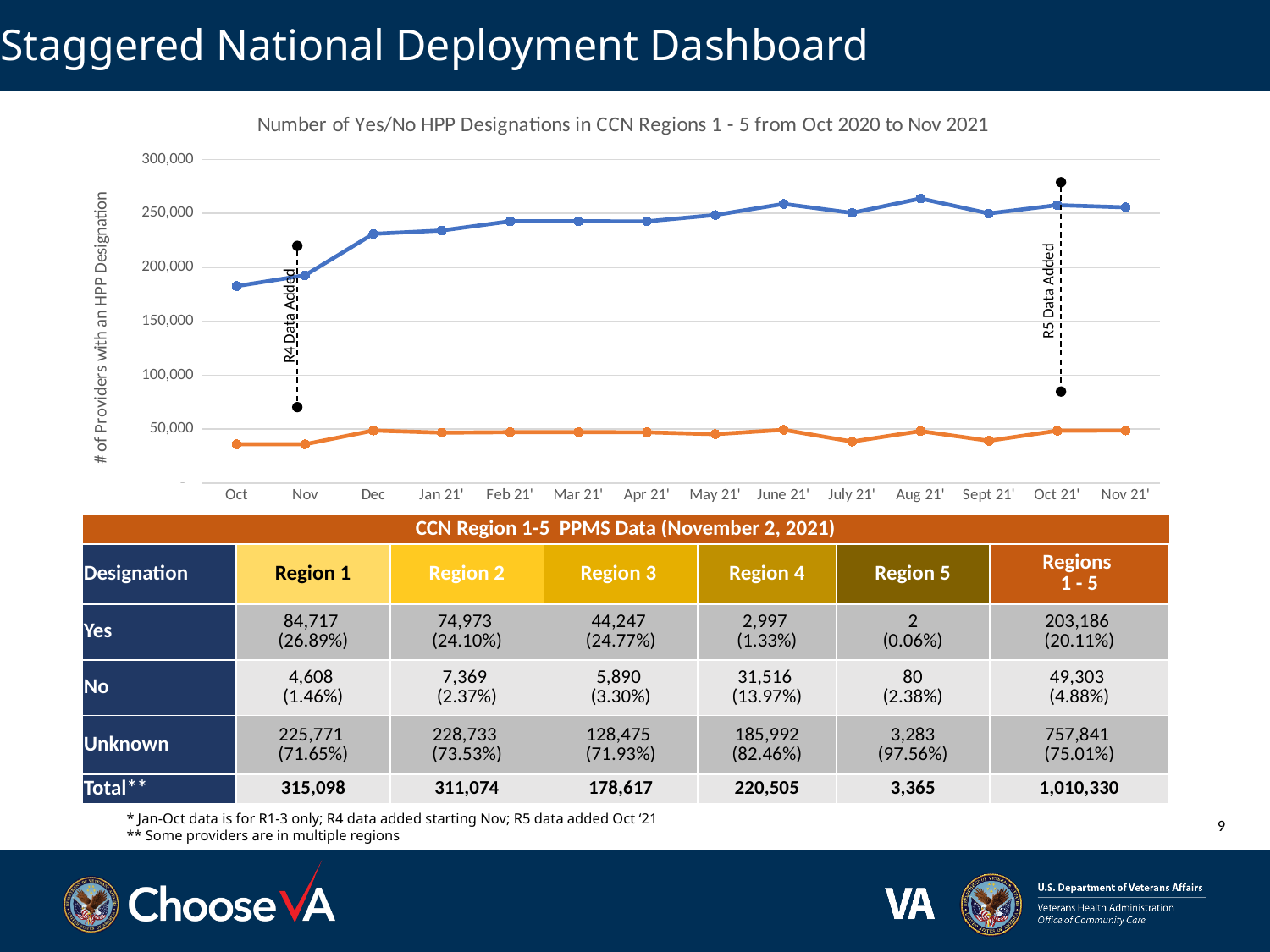
Is the value of the blue line at Aug 21' greater or less than 250,000? greater What kind of chart is shown on the slide? line chart Does the blue line generally rise or fall from Oct to Nov 21'? rise Is the value of the orange line at July 21' greater or less than 50,000? less What is the title of the chart? Number of Yes/No HPP Designations in CCN Regions 1 - 5 from Oct 2020 to Nov 2021 Is the value of the blue line at Oct greater or less than 200,000? less At which x-axis point is the blue line at its lowest value? Oct What is the label on the vertical axis of the chart? # of Providers with an HPP Designation At Mar 21', which line has the higher value, the blue line or the orange line? blue line How many time points are plotted along the x axis of the chart? 14